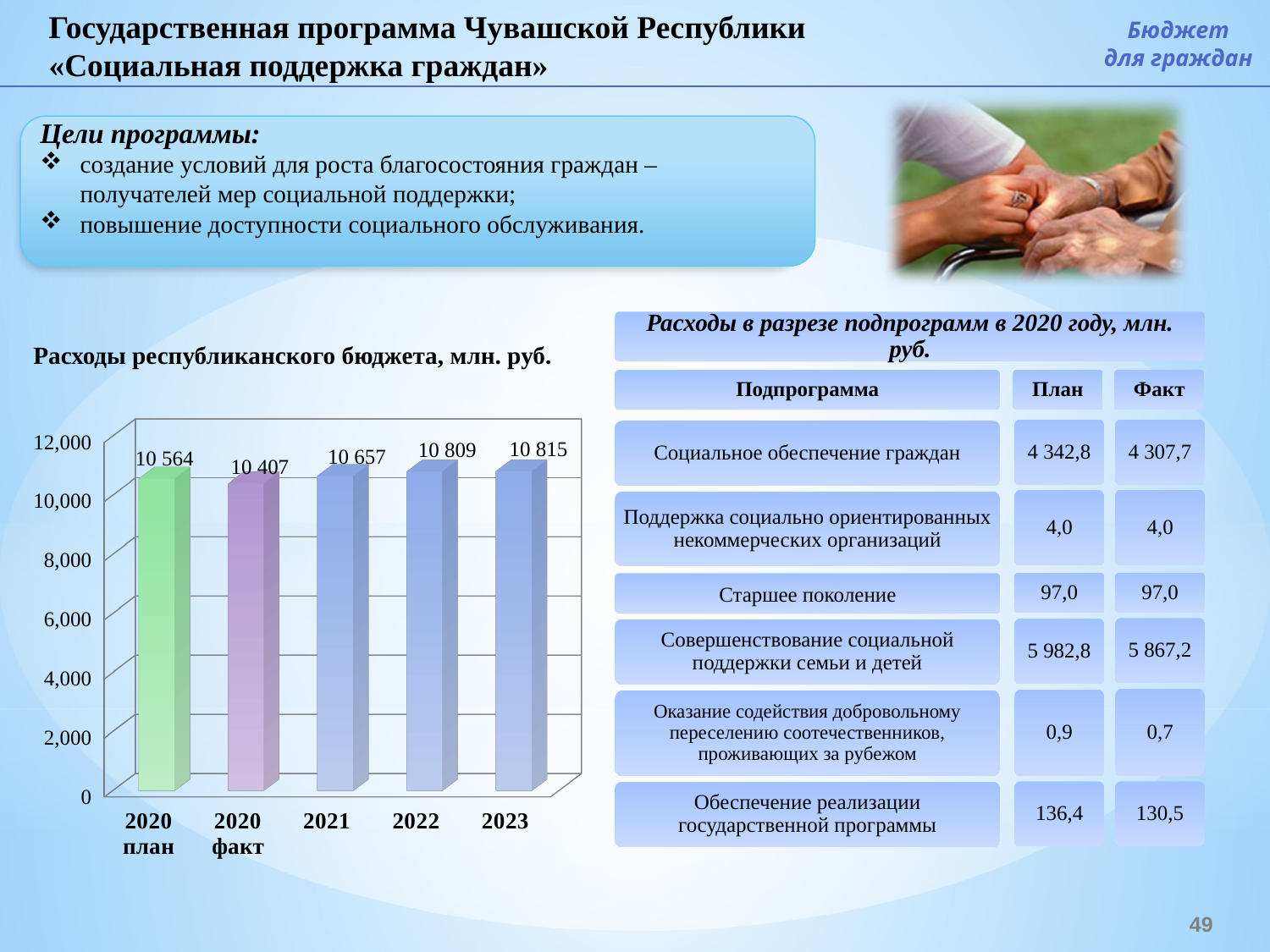
Which category has the highest value in the chart? 2023 What kind of chart is shown on the slide? bar chart How many bars are shown in the chart? 5 What is the difference between the 2023 and 2021 values in the chart? 158 What is the value for 2020 план in the chart 'Расходы республиканского бюджета, млн. руб.'? 10 564 Which category has the lowest value in the chart? 2020 факт Which is larger in the chart, the value for 2021 or the value for 2020 факт? 2021 What is the title of the chart on the slide? Расходы республиканского бюджета, млн. руб. Is the value for 2022 in the chart greater or less than 10,000? greater What is the value shown for 2022 in the chart? 10 809 What is the value for 2020 факт in the chart? 10 407 What is the difference between the 2020 план and 2020 факт values in the chart? 157